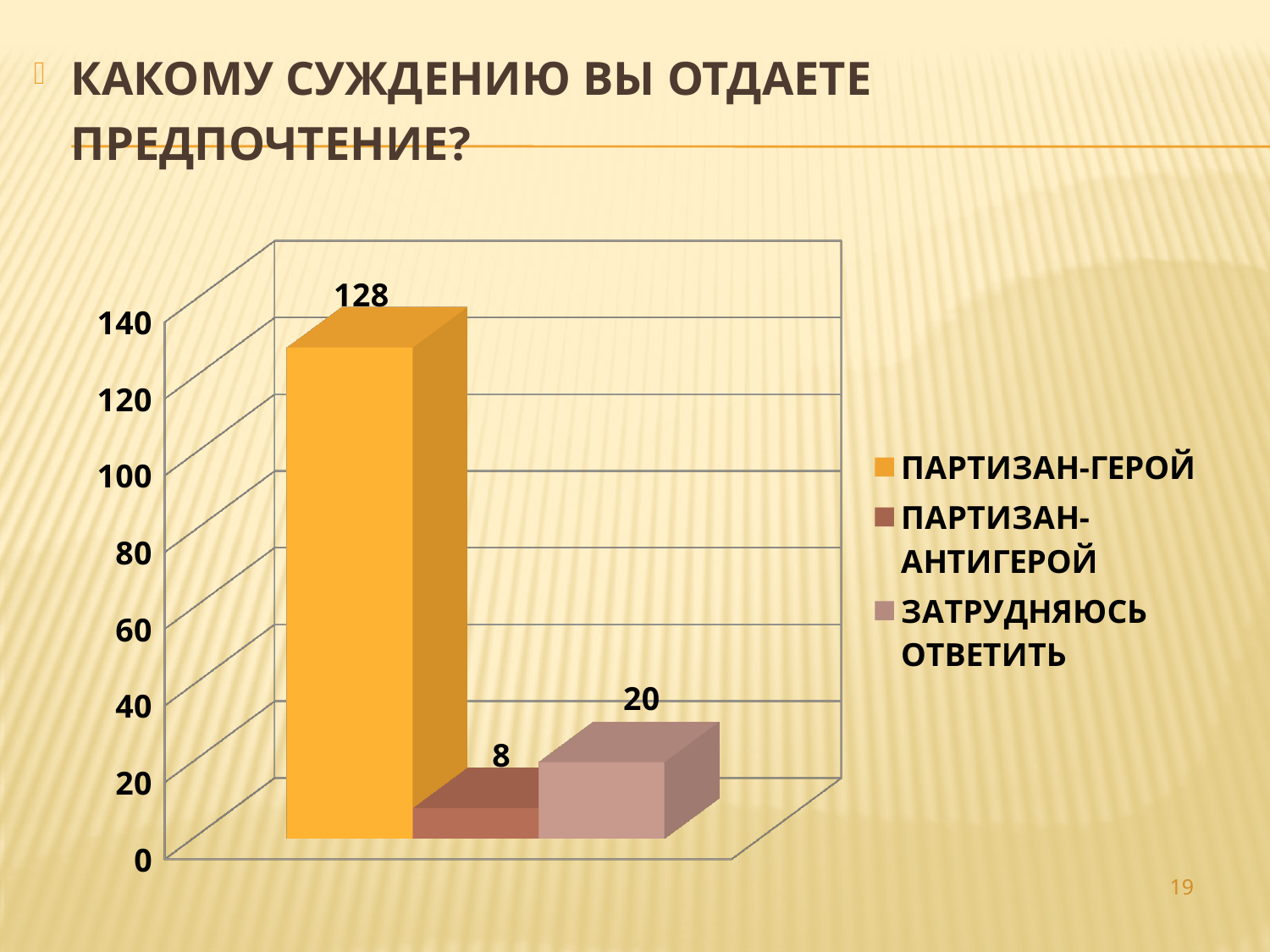
Which is larger, the value for ЗАТРУДНЯЮСЬ ОТВЕТИТЬ or the value for ПАРТИЗАН-АНТИГЕРОЙ? ЗАТРУДНЯЮСЬ ОТВЕТИТЬ What is the value for ПАРТИЗАН-ГЕРОЙ? 128 Is the value for ПАРТИЗАН-ГЕРОЙ greater or less than 100? greater What is the difference between the values for ЗАТРУДНЯЮСЬ ОТВЕТИТЬ and ПАРТИЗАН-АНТИГЕРОЙ? 12 Which category has the highest value? ПАРТИЗАН-ГЕРОЙ What colour is the bar for ПАРТИЗАН-ГЕРОЙ? orange Which category has the lowest value? ПАРТИЗАН-АНТИГЕРОЙ How many entries does the legend list? 3 What is the value for ЗАТРУДНЯЮСЬ ОТВЕТИТЬ? 20 What kind of chart is shown on the slide? bar chart What is the value for ПАРТИЗАН-АНТИГЕРОЙ? 8 What is the difference between the values for ПАРТИЗАН-ГЕРОЙ and ЗАТРУДНЯЮСЬ ОТВЕТИТЬ? 108